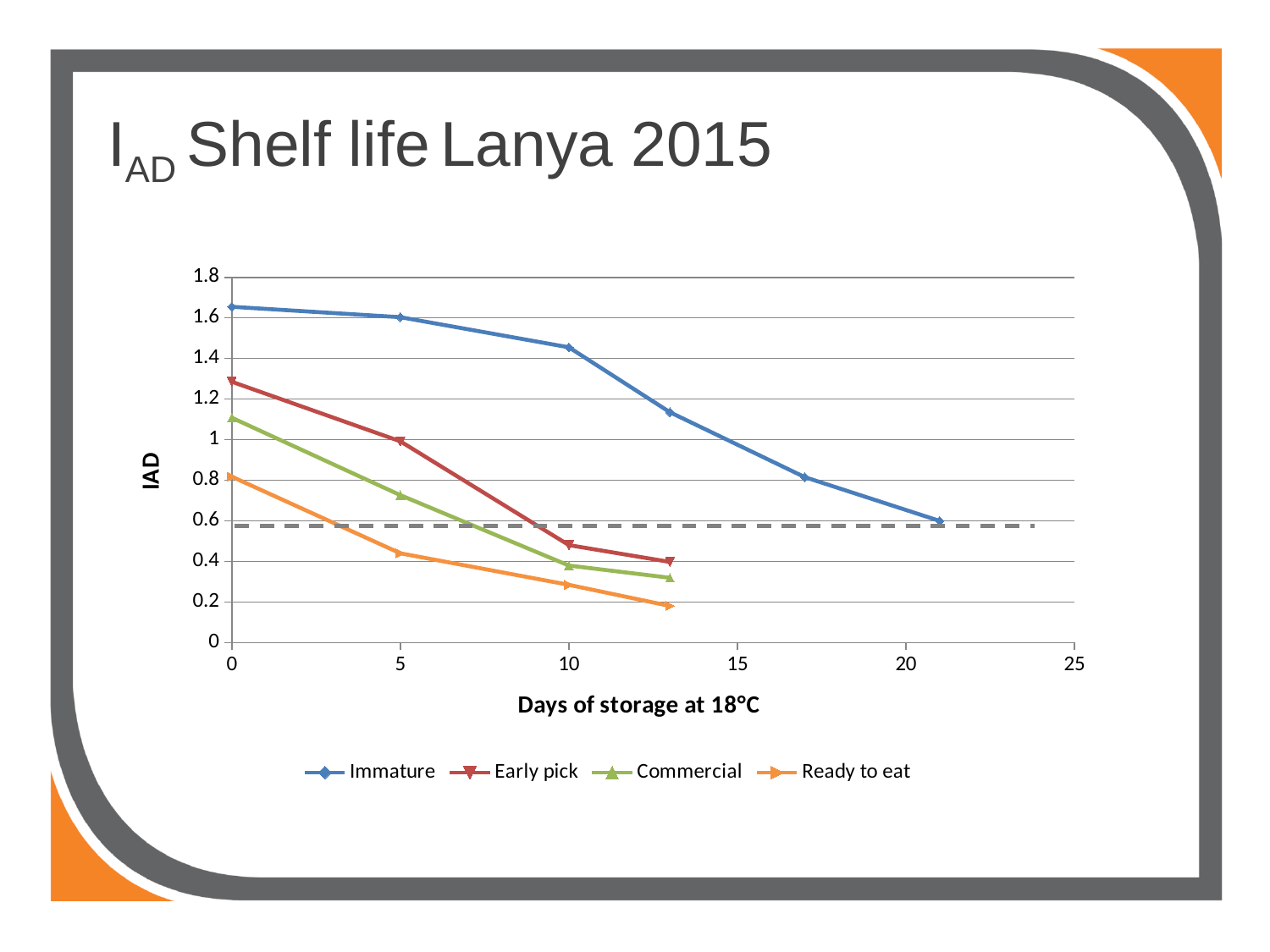
At day 10, which series has the larger IAD value, Early pick or Commercial? Early pick Is the IAD value for Early pick at day 0 greater or less than 1.2? greater How many series does the legend list? 4 Is the IAD value for Ready to eat at day 5 greater or less than 0.6? less What is the title of the y axis? IAD Is the IAD value for Immature at day 17 greater or less than 1? less How many data points are plotted for the Immature series? 6 What is the title of the x axis? Days of storage at 18°C Which series has the lowest IAD value at day 0? Ready to eat Do the IAD values rise or fall as days of storage increase? fall Which series has the highest IAD value at day 0? Immature What kind of chart is shown on the slide? line chart